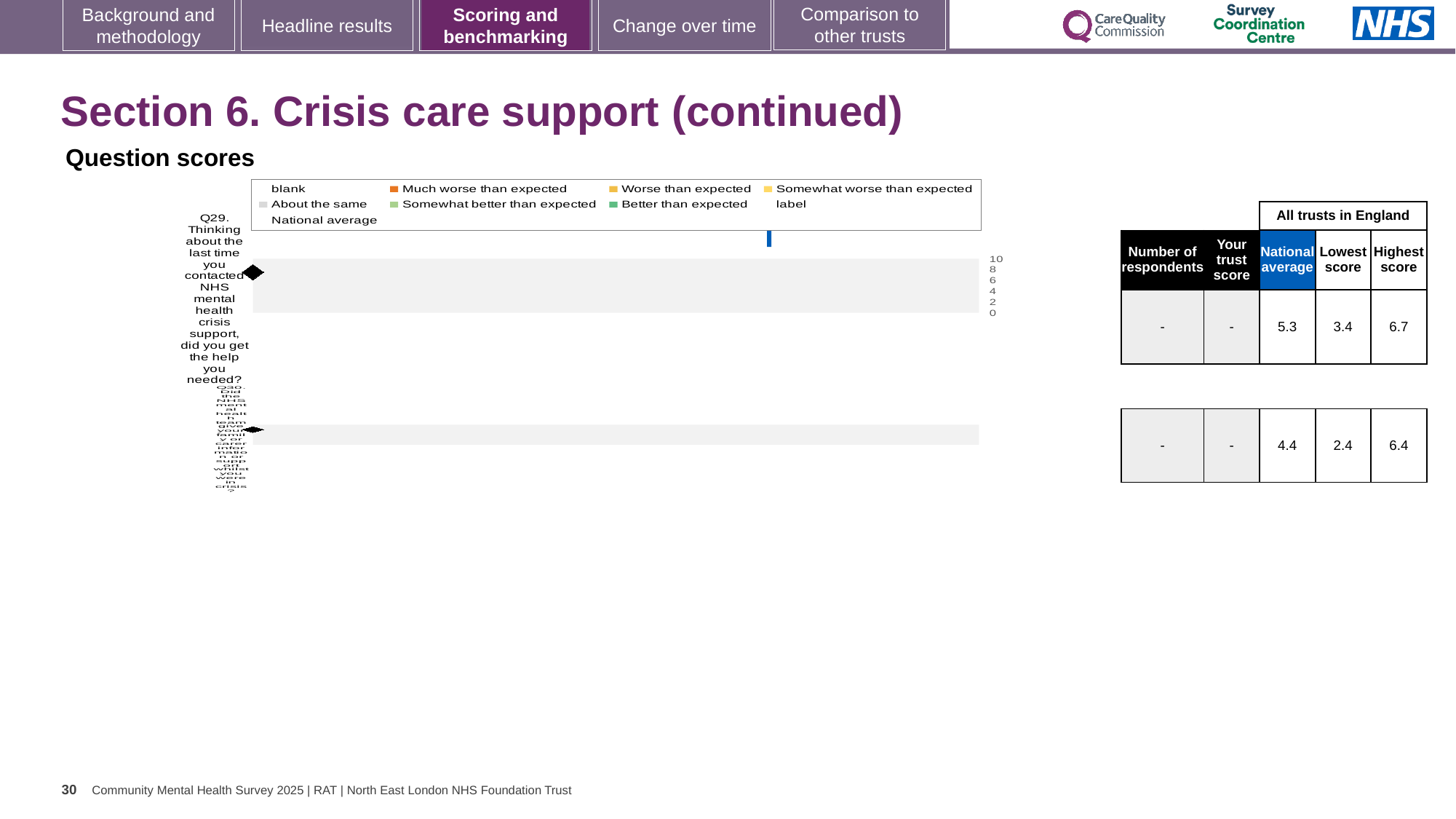
In the table next to the chart, what is the national average score for Q30? 4.4 In the table next to the chart, what is the lowest score across all trusts in England for Q29? 3.4 What is the difference between the highest and lowest scores for Q29 in the table? 3.3 What kind of chart is shown under 'Question scores'? bar chart How many questions (categories) are plotted on the chart? 2 In the table next to the chart, what is the highest score across all trusts in England for Q29? 6.7 Which question has the higher national average score, Q29 or Q30? Q29 In the table next to the chart, what is the lowest score across all trusts in England for Q30? 2.4 What is the maximum value shown on the chart's axis? 10 In the table next to the chart, what is the highest score across all trusts in England for Q30? 6.4 In the table next to the chart, what is the national average score for Q29? 5.3 Which legend entry is shown with an orange marker? Much worse than expected